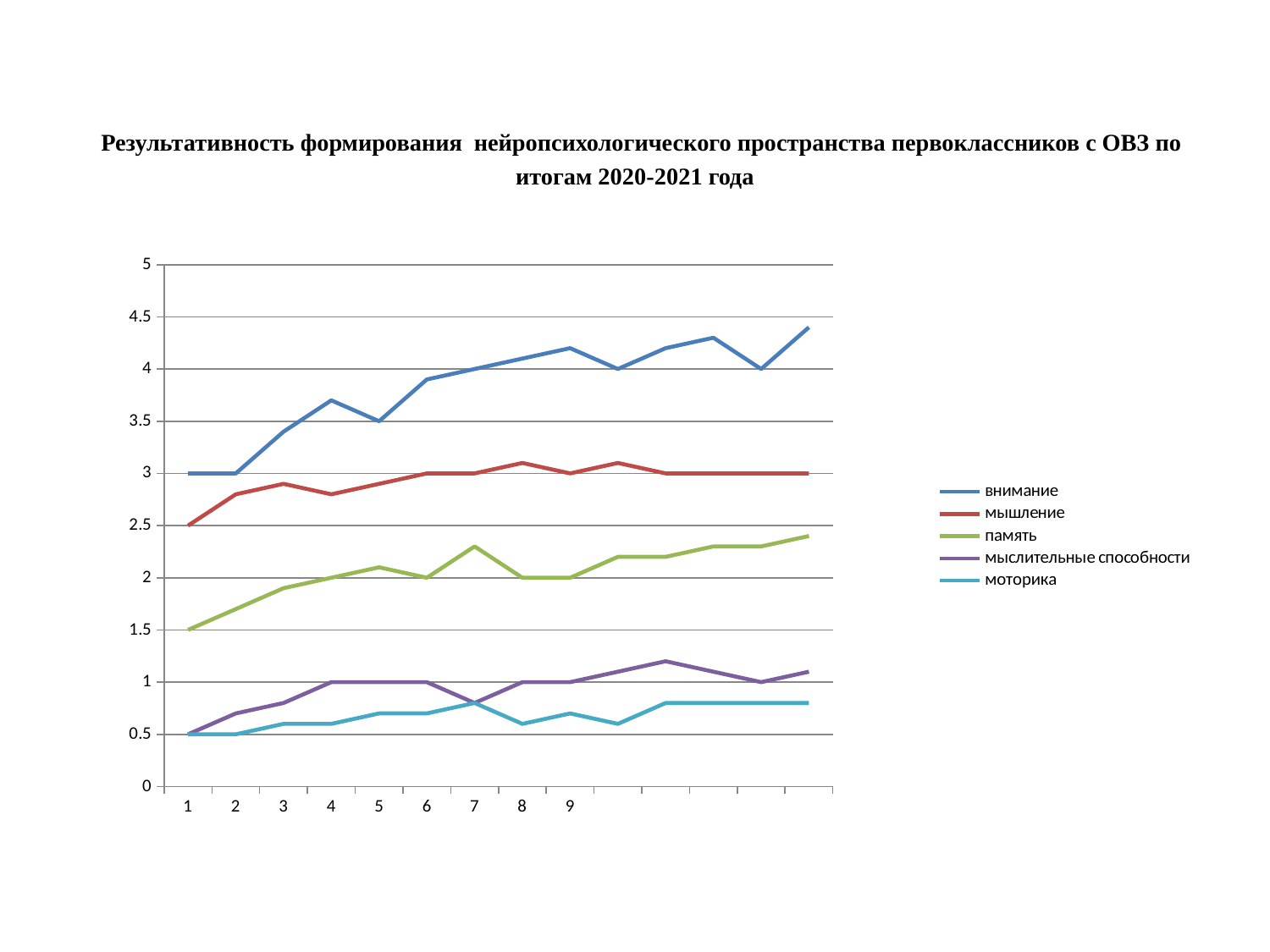
At point 8, which series has the lowest value? моторика What is the value of the внимание series at point 1? 3 What kind of chart is shown on the slide? line chart What is the value of the мышление series at point 1? 2.5 Which series has the highest values across the chart? внимание Is the value of the внимание series at point 7 greater or less than 3.5? greater What is the value of the мыслительные способности series at point 4? 1 How many series does the legend list? 5 What is the value of the память series at point 1? 1.5 Does the внимание series generally rise or fall along the x axis? rise What is the value of the моторика series at point 1? 0.5 Is the value of the моторика series at point 8 greater or less than 1? less